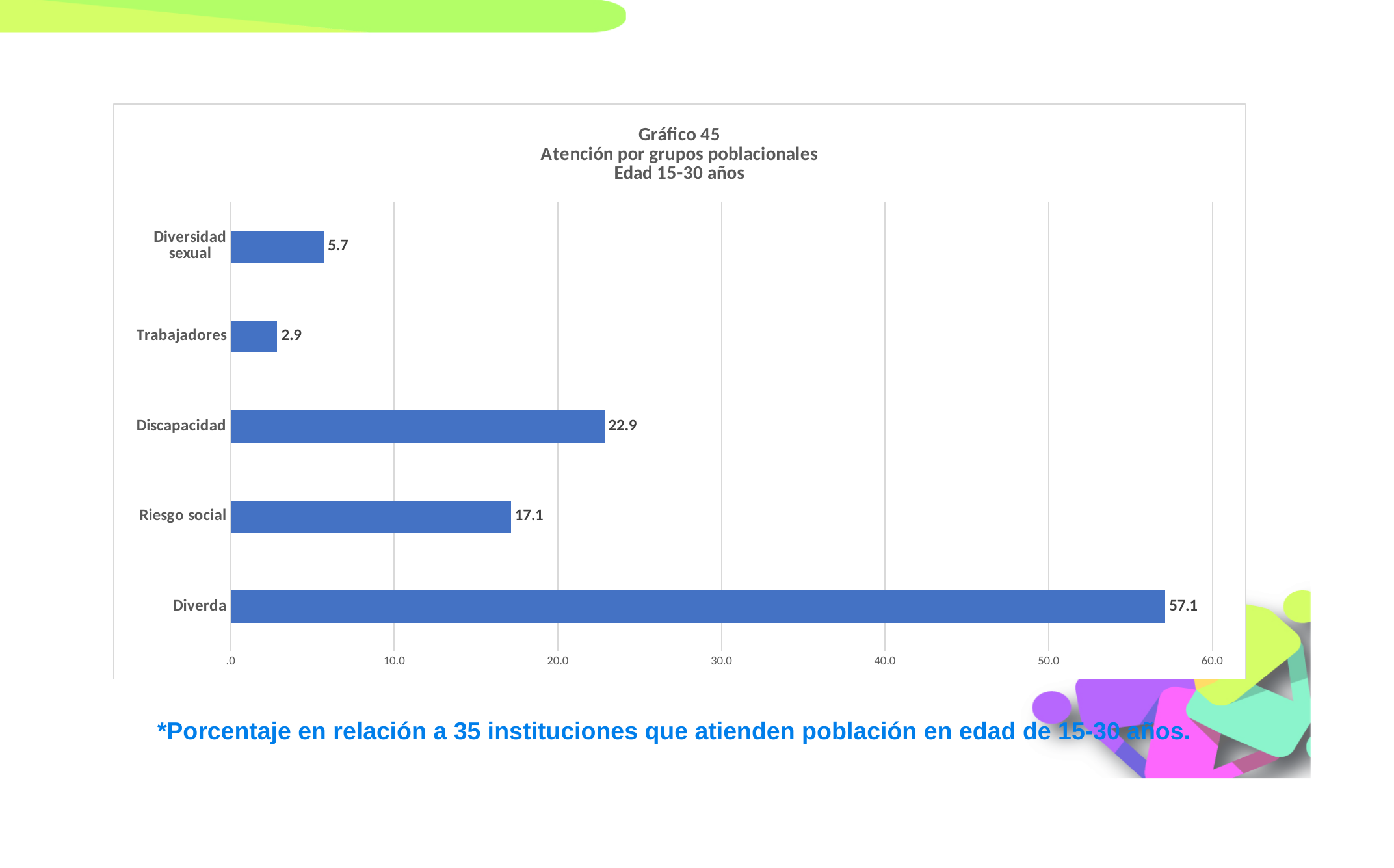
What is the value for Diversidad sexual? 5.7 Which is larger, the value for Riesgo social or the value for Diversidad sexual? Riesgo social Which category has the lowest value? Trabajadores Which category has the highest value? Diverda What kind of chart is shown on the slide? Bar chart What is the title of the chart? Gráfico 45 Atención por grupos poblacionales Edad 15-30 años What is the value for Trabajadores? 2.9 What is the value for Diverda? 57.1 Is the value for Diverda greater or less than 50.0? greater What is the value for Discapacidad? 22.9 What is the difference between the values for Discapacidad and Riesgo social? 5.8 How many categories are shown in the chart? 5